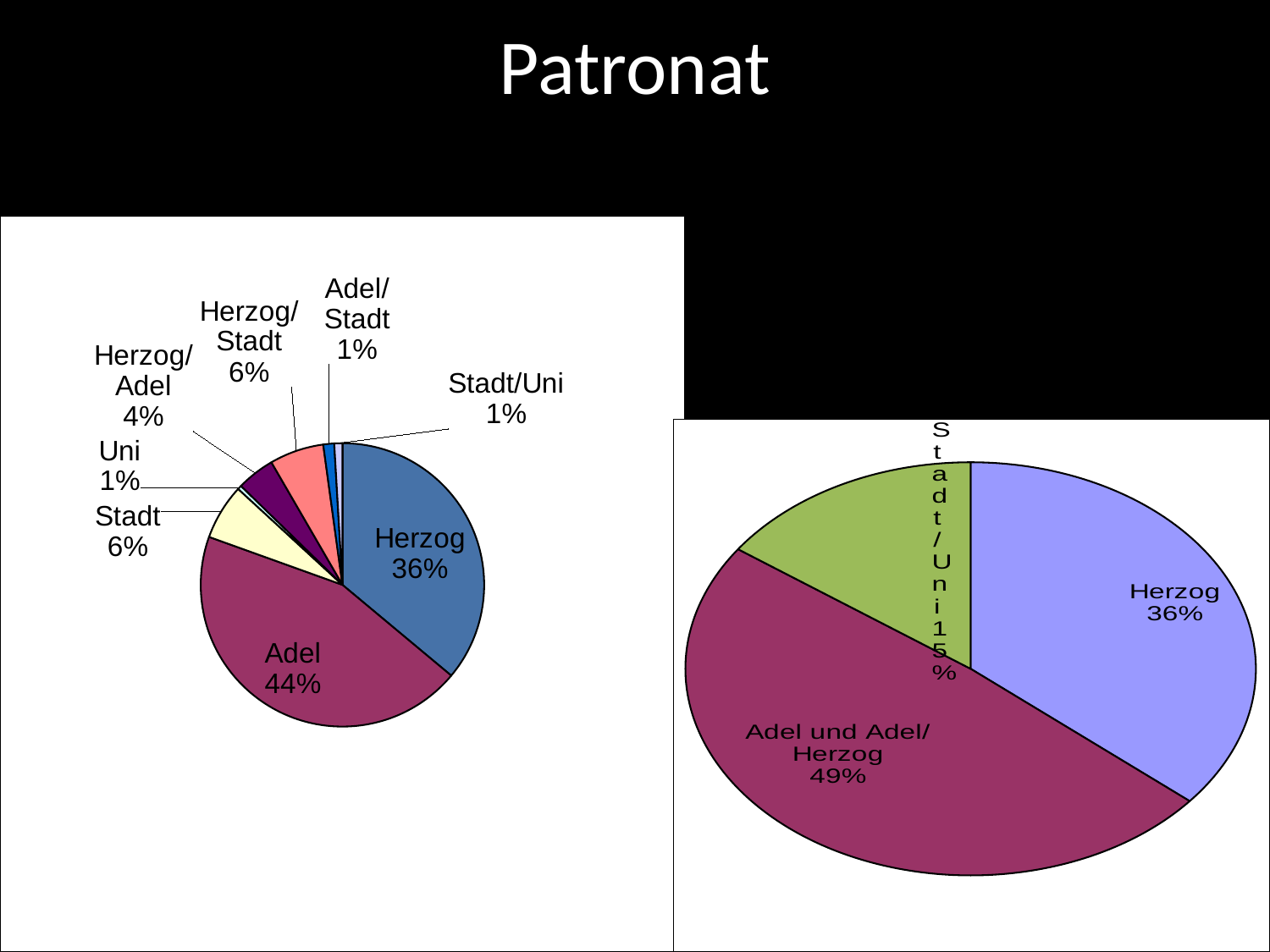
In the left pie chart, what share does Adel have? 44% What type of chart is shown on the right of the slide? Pie chart In the right pie chart, which category has the smallest share? Stadt/Uni In the left pie chart, which is larger, Stadt or Herzog/Adel? Stadt In the left pie chart, which category has the largest share? Adel In the left pie chart, how many slices are there? 8 In the left pie chart, what share does Herzog have? 36% In the right pie chart, how many slices are there? 3 In the left pie chart, what share does Herzog/Adel have? 4% In the left pie chart, what is the difference between the shares of Adel and Herzog? 8% In the right pie chart, what share does Adel und Adel/Herzog have? 49% In the right pie chart, what share does Stadt/Uni have? 15%